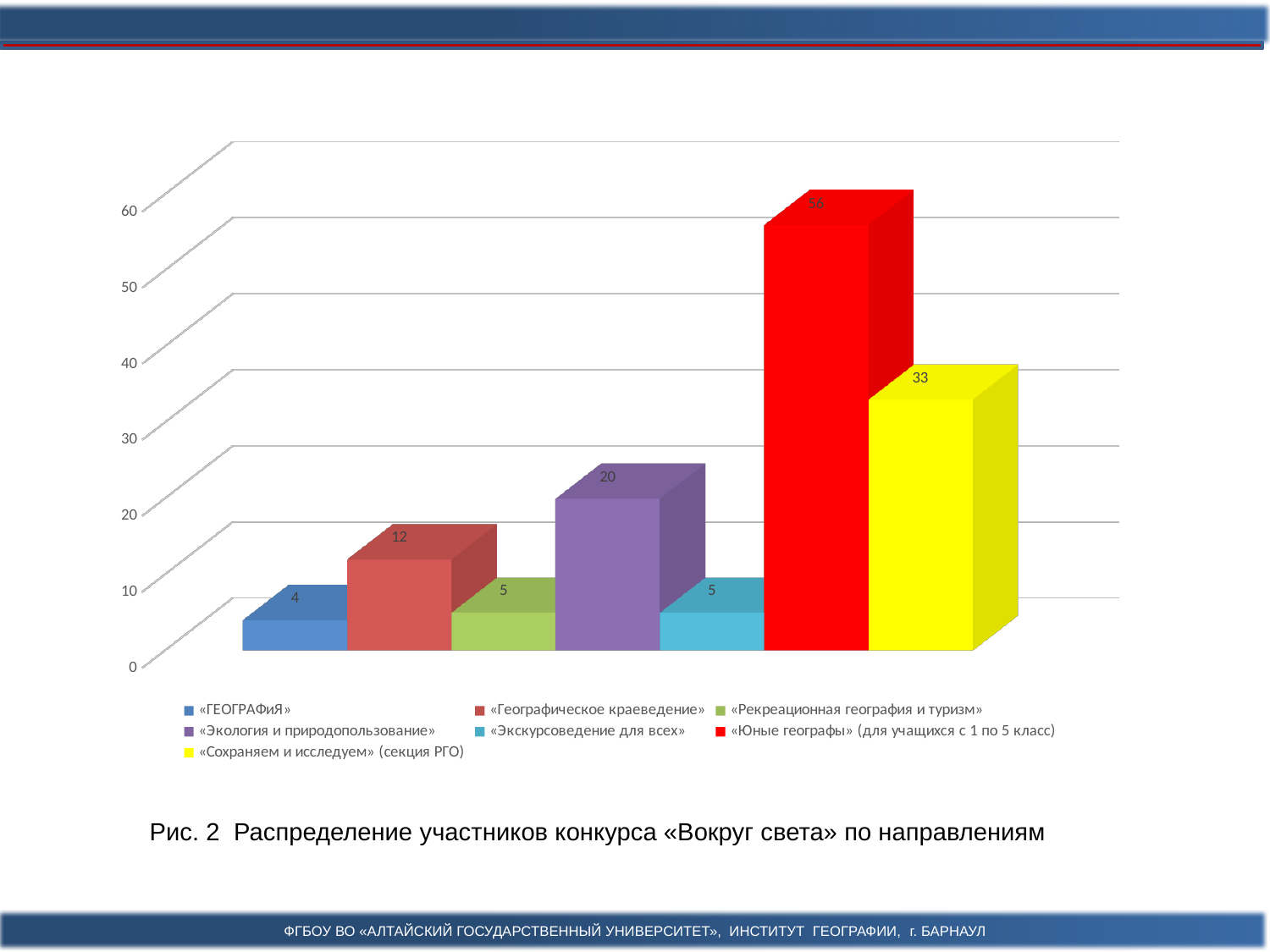
What is the value for «Географическое краеведение»? 12 What is the difference between the values for «Юные географы» and «Сохраняем и исследуем»? 23 What kind of chart is shown on the slide? bar chart Is the value for «Сохраняем и исследуем» (секция РГО) greater or less than 30? greater What is the value for «Сохраняем и исследуем» (секция РГО)? 33 What is the value for «Юные географы» (для учащихся с 1 по 5 класс)? 56 How many series does the legend list? 7 What is the value for «Экология и природопользование»? 20 Which is larger: the value for «Экология и природопользование» or for «Географическое краеведение»? «Экология и природопользование» What is the caption of the chart on the slide? Рис. 2 Распределение участников конкурса «Вокруг света» по направлениям Which direction has the highest number of participants? «Юные географы» (для учащихся с 1 по 5 класс) Which direction has the lowest number of participants? «ГЕОГРАФиЯ»